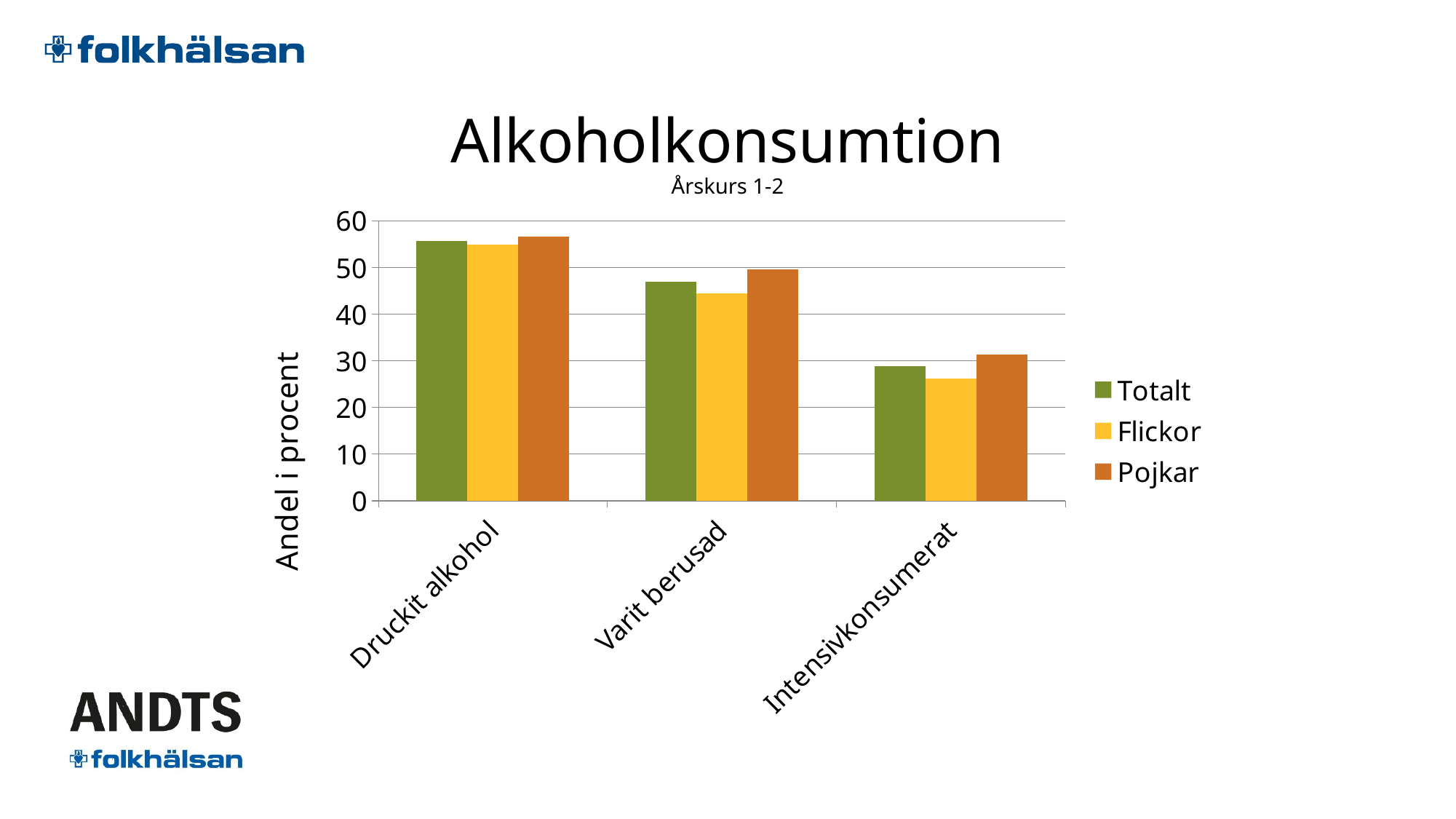
Is the value for Flickor in Intensivkonsumerat greater or less than 30? less Is the value for Flickor in Varit berusad greater or less than 50? less Do the values for Totalt rise or fall from left to right across the categories? fall What kind of chart is shown on the slide? bar chart Which category has the highest value for Pojkar? Druckit alkohol What is the label on the vertical axis? Andel i procent For Intensivkonsumerat, which is larger: Flickor or Pojkar? Pojkar Which category has the lowest value for Flickor? Intensivkonsumerat How many categories are shown on the x axis? 3 For Varit berusad, which is larger: Flickor or Pojkar? Pojkar How many series does the legend list? 3 Is the value for Totalt in Druckit alkohol greater or less than 50? greater